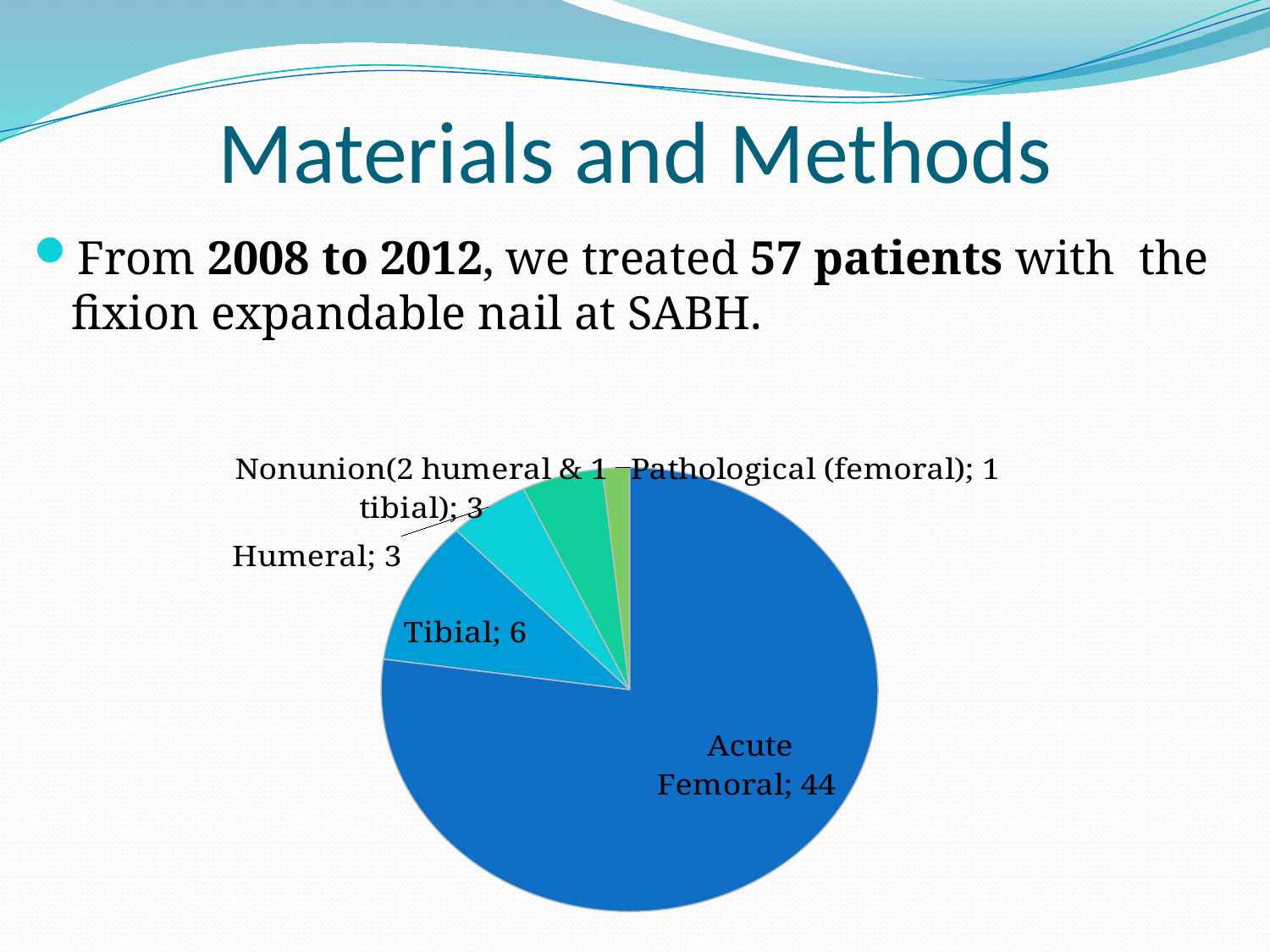
What is the value for Acute Femoral in the pie chart? 44 What is the total of all slices in the pie chart? 57 Which category has the smallest slice in the pie chart? Pathological (femoral) What is the value for Nonunion (2 humeral & 1 tibial) in the pie chart? 3 What is the value for Humeral in the pie chart? 3 Which category has the largest slice in the pie chart? Acute Femoral Which is larger in the pie chart, Tibial or Humeral? Tibial What is the difference between the Acute Femoral value and the Tibial value in the pie chart? 38 How many slices does the pie chart have? 5 What kind of chart is shown on the slide? Pie chart What is the value for Pathological (femoral) in the pie chart? 1 What is the value for Tibial in the pie chart? 6